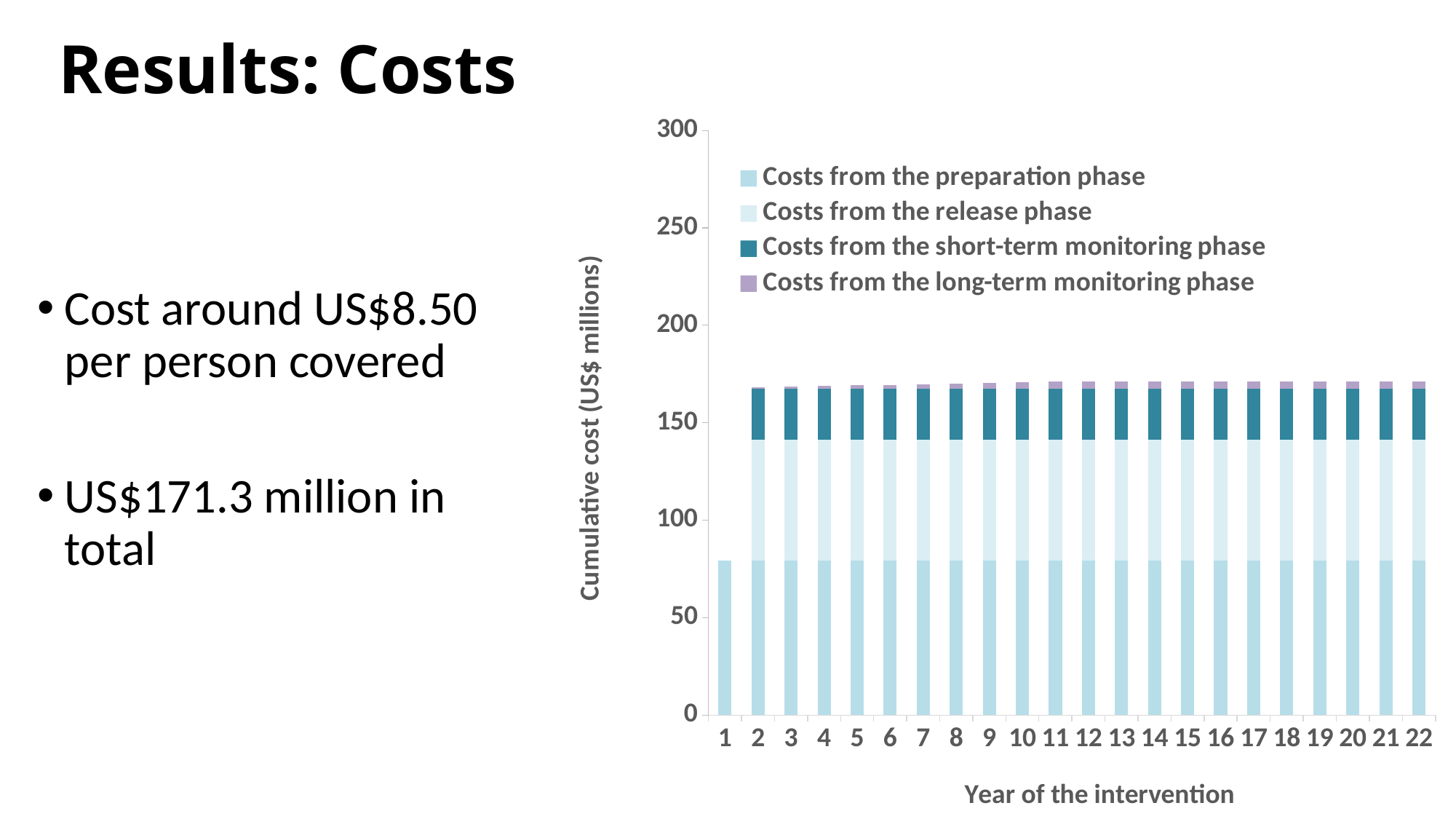
Which has the larger total cumulative cost, year 1 or year 2? Year 2 Is the total cumulative cost for year 2 greater or less than 200? less Is the total cumulative cost for year 1 greater or less than 50? greater How many series does the chart legend list? 4 Which year of the intervention has the lowest total cumulative cost in the chart? 1 Which series appears in the bar for year 1 of the intervention? Costs from the preparation phase How many years of the intervention are shown on the x axis of the chart? 22 Is the total cumulative cost for year 1 greater or less than 100? less Does the total cumulative cost rise or fall from year 1 to year 22? Rise What kind of chart is shown on the slide? Stacked bar chart What is the label of the y axis of the chart? Cumulative cost (US$ millions)